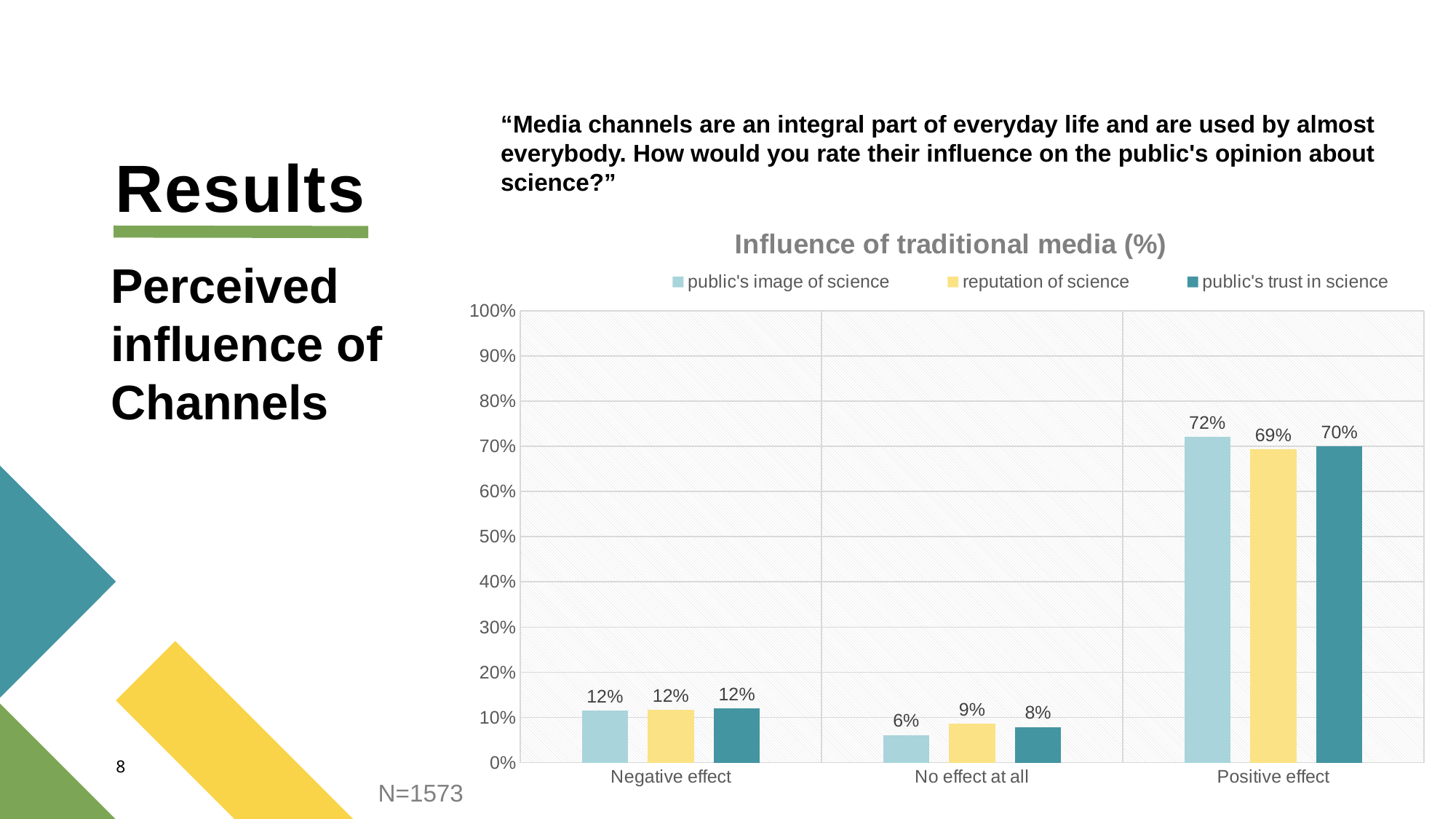
Is the value for "public's trust in science" in the "Positive effect" category greater or less than 60%? greater What is the title of the chart? Influence of traditional media (%) What is the difference between the "public's image of science" and "reputation of science" values in the "Positive effect" category? 3% How many series does the legend list? 3 Which category has the lowest value for "public's image of science"? No effect at all Which category has the highest value for "public's trust in science"? Positive effect How many categories are shown on the x axis? 3 What is the value for "reputation of science" in the "No effect at all" category? 9% In the "No effect at all" category, which is larger: "reputation of science" or "public's image of science"? reputation of science What is the value for "public's trust in science" in the "Negative effect" category? 12% What kind of chart is shown on the slide? bar chart What is the value for "public's image of science" in the "Positive effect" category? 72%